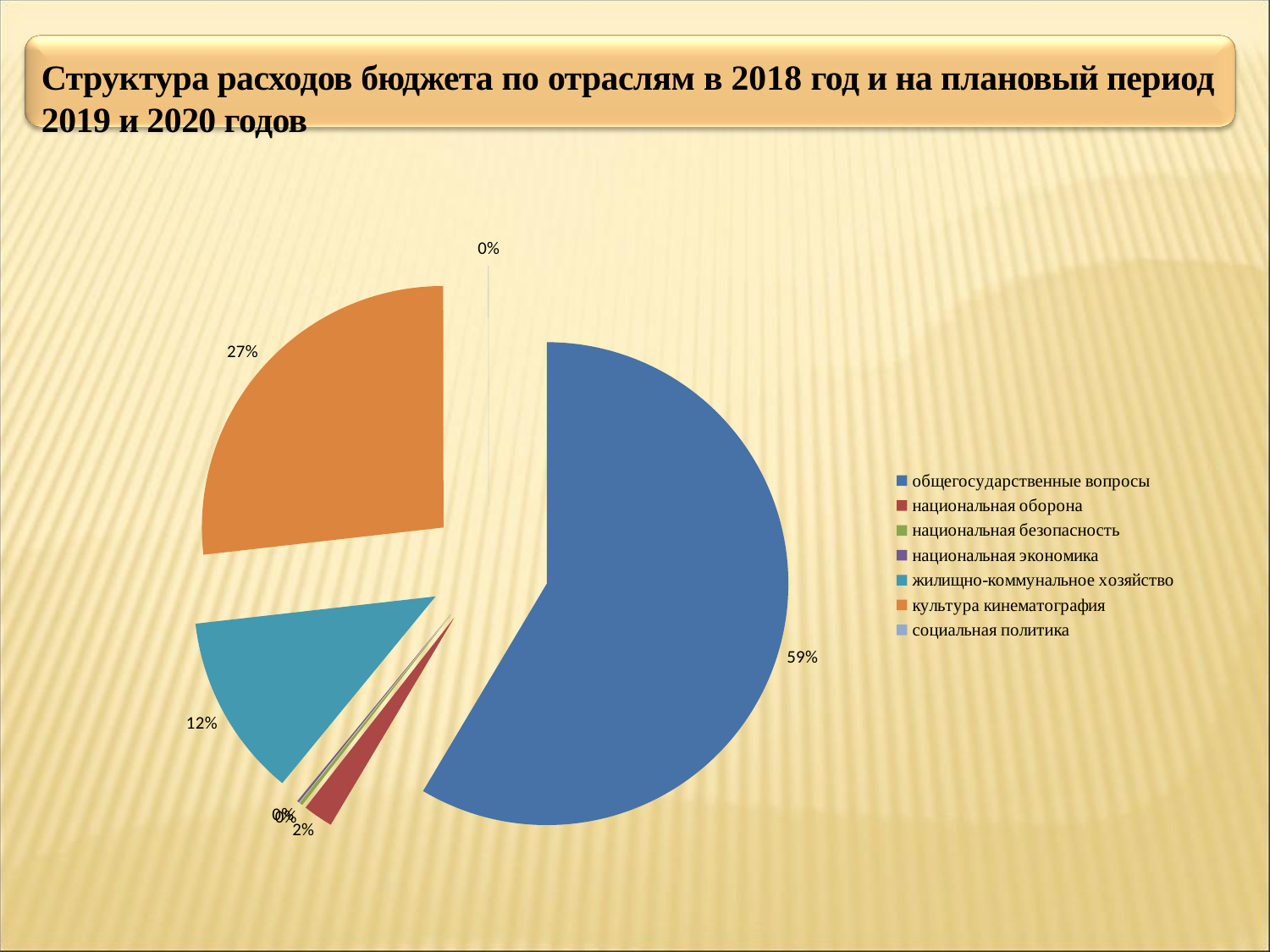
What is the title of the slide? Структура расходов бюджета по отраслям в 2018 год и на плановый период 2019 и 2020 годов Which category has the largest slice of the pie? общегосударственные вопросы What colour is the slice for культура кинематография? orange What is the difference between the share for общегосударственные вопросы and the share for культура кинематография? 32% Which is larger, the slice for культура кинематография or the slice for жилищно-коммунальное хозяйство? культура кинематография How many entries does the legend list? 7 What share of the pie does национальная оборона take? 2% What is the difference between the share for жилищно-коммунальное хозяйство and the share for национальная оборона? 10% What share of the pie does общегосударственные вопросы take? 59% What kind of chart is shown on the slide? pie chart What share of the pie does культура кинематография take? 27%